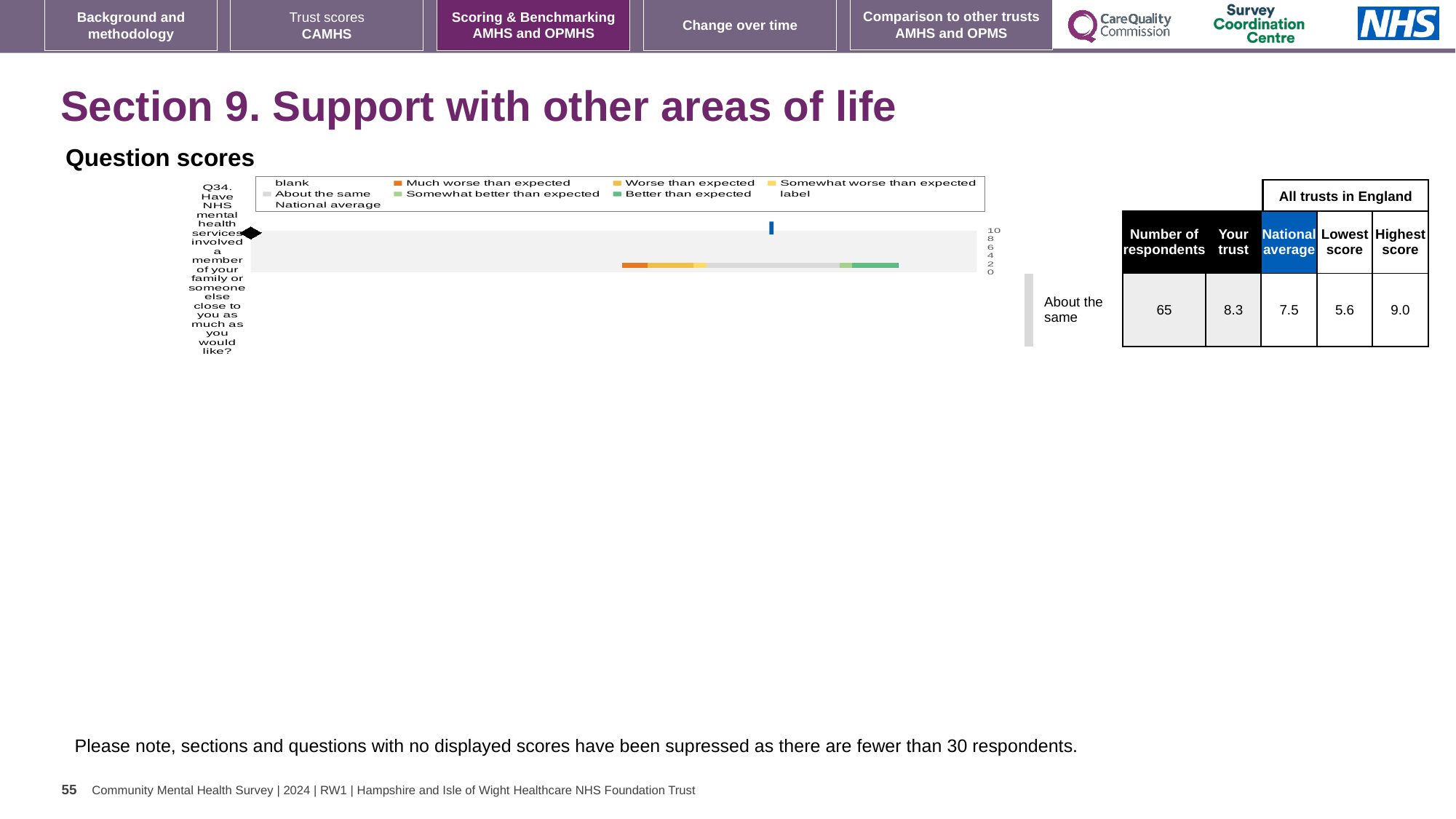
What kind of chart is shown under 'Question scores'? bar chart In the chart legend, what colour represents 'Much worse than expected'? orange Which question number is plotted in the Question scores chart? Q34 In the table beside the chart, what is the national average score for Q34? 7.5 In the table beside the chart, which is larger for Q34: the 'Your trust' score or the national average? Your trust In the table beside the chart, what is the 'Your trust' score for Q34? 8.3 Which benchmark category label is shown next to the Q34 bar? About the same In the table beside the chart, what is the difference between the 'Your trust' score and the national average for Q34? 0.8 How many entries does the legend of the Question scores chart list? 9 How many questions (categories) are plotted in the Question scores chart? 1 In the table beside the chart, what is the difference between the highest score and the lowest score for Q34? 3.4 In the table beside the chart, how many respondents answered Q34? 65